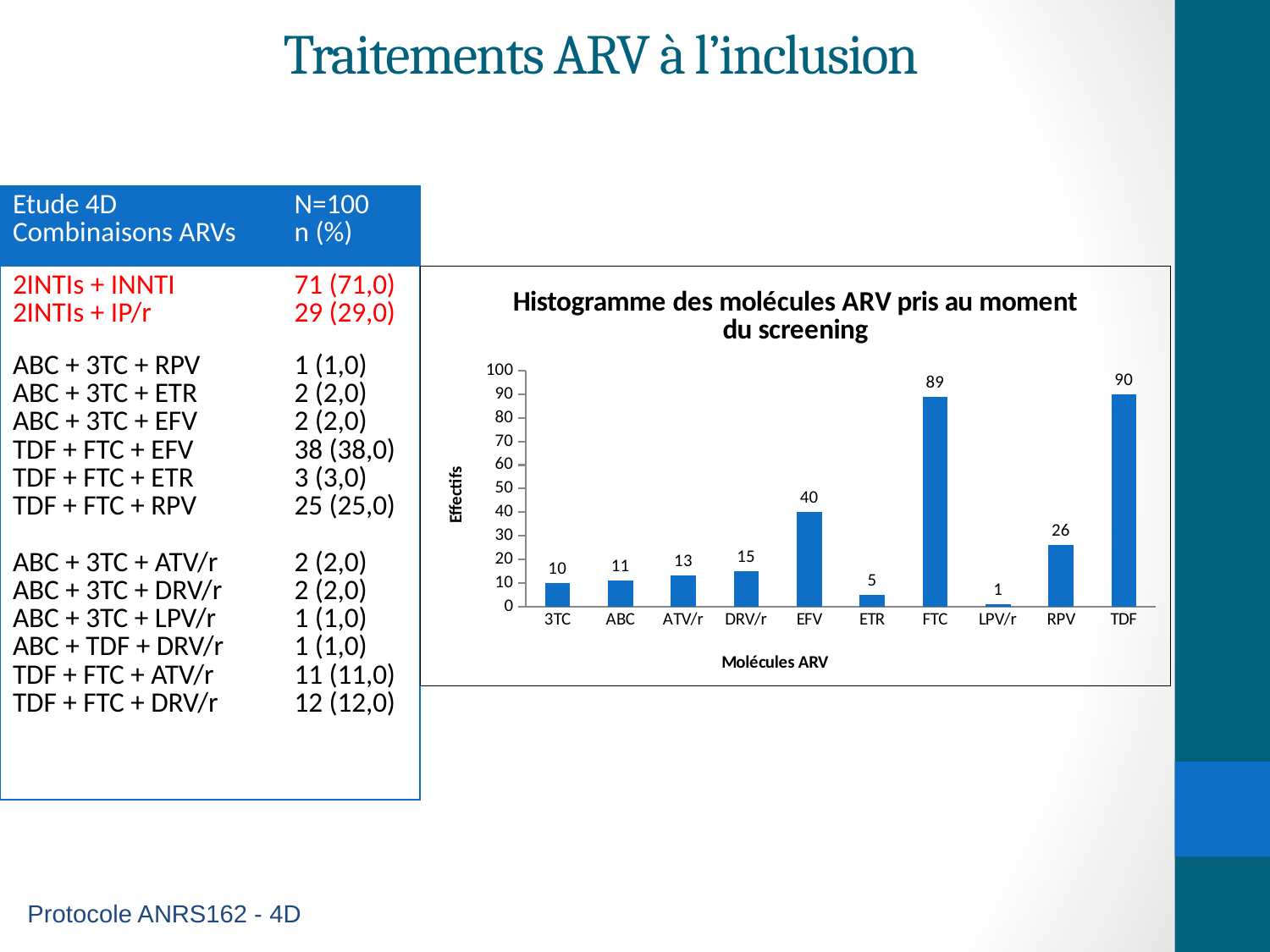
What is the value for EFV in the chart? 40 What kind of chart is shown on the slide? bar chart Which molecule has the highest value in the chart? TDF Which is larger, the value for ATV/r or the value for DRV/r? DRV/r What is the value for FTC in the chart? 89 How many molecules are shown on the x axis of the chart? 10 Which molecule has the lowest value in the chart? LPV/r What is the label of the y axis of the chart? Effectifs Is the value for ETR greater or less than 10? less What is the value for RPV in the chart? 26 What is the difference between the values for EFV and RPV? 14 What is the difference between the values for TDF and FTC? 1